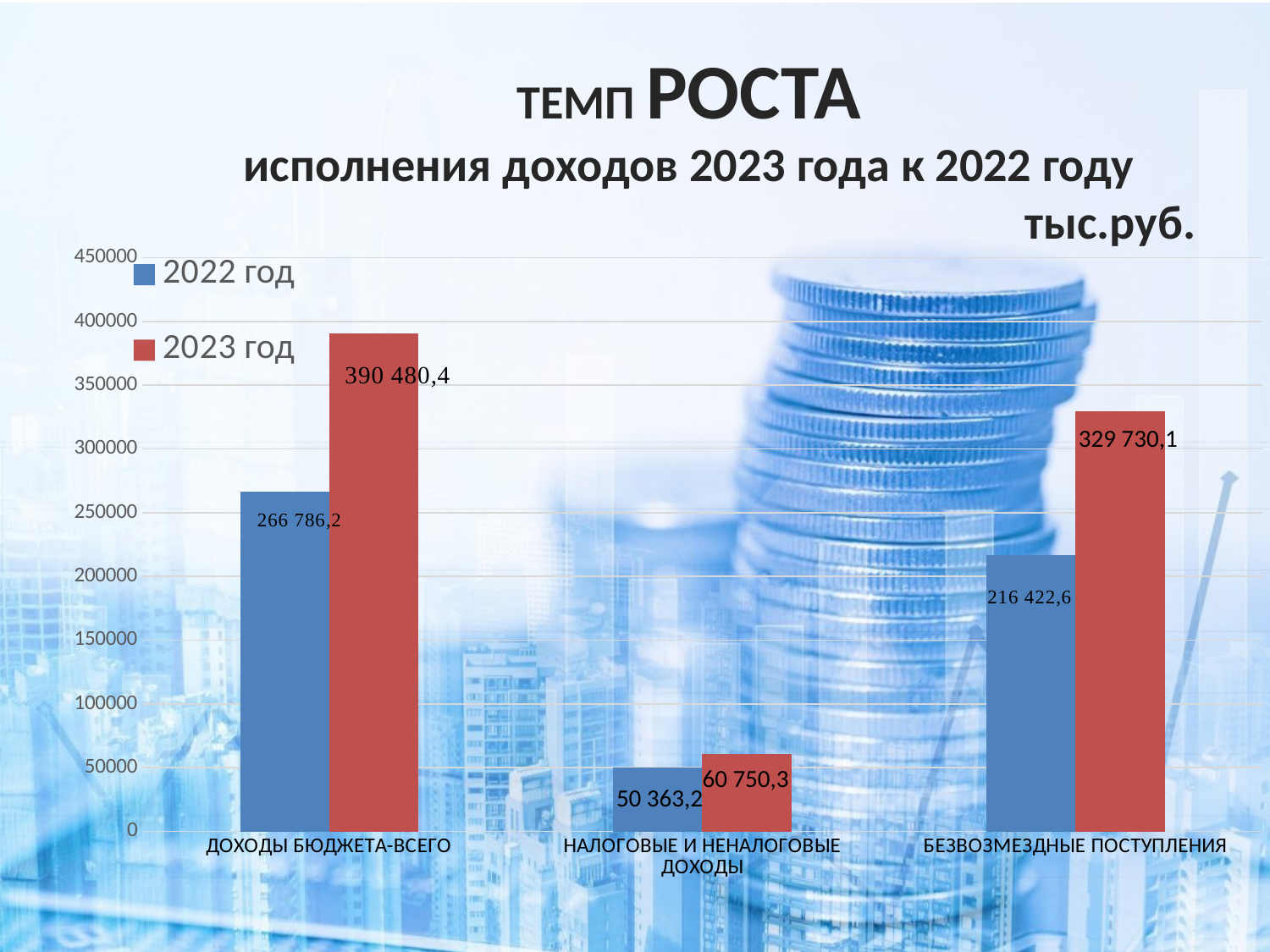
Which category has the lowest value in the 2022 год series? НАЛОГОВЫЕ И НЕНАЛОГОВЫЕ ДОХОДЫ What is the value for БЕЗВОЗМЕЗДНЫЕ ПОСТУПЛЕНИЯ in the 2023 год series? 329 730,1 What kind of chart is shown on the slide? Bar chart What is the difference between the 2023 год and 2022 год values for ДОХОДЫ БЮДЖЕТА-ВСЕГО? 123 694,2 How many series does the legend list? 2 What is the value for ДОХОДЫ БЮДЖЕТА-ВСЕГО in the 2023 год series? 390 480,4 What is the value for БЕЗВОЗМЕЗДНЫЕ ПОСТУПЛЕНИЯ in the 2022 год series? 216 422,6 Which category has the highest value in the 2023 год series? ДОХОДЫ БЮДЖЕТА-ВСЕГО How many categories are shown on the x axis? 3 What is the value for НАЛОГОВЫЕ И НЕНАЛОГОВЫЕ ДОХОДЫ in the 2022 год series? 50 363,2 What is the difference between the 2023 год and 2022 год values for НАЛОГОВЫЕ И НЕНАЛОГОВЫЕ ДОХОДЫ? 10 387,1 Which is larger for БЕЗВОЗМЕЗДНЫЕ ПОСТУПЛЕНИЯ: the 2022 год value or the 2023 год value? 2023 год